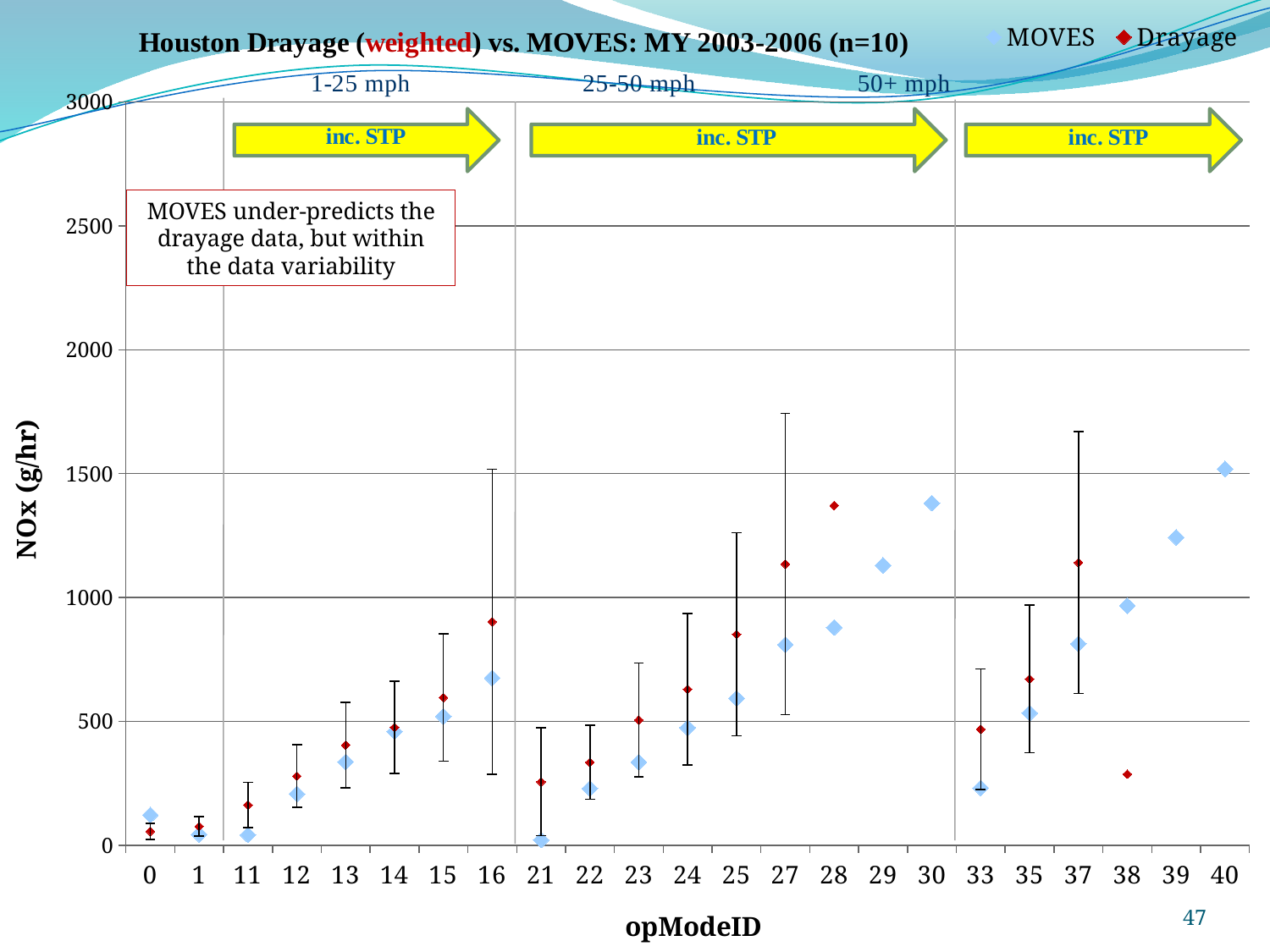
Is the MOVES value for opModeID 30 greater or less than 1000? greater Which opModeID has the highest MOVES value? 40 At opModeID 16, which series has the larger value, MOVES or Drayage? Drayage Do the MOVES values rise or fall from opModeID 21 to opModeID 30? rise What kind of chart is shown on the slide? Scatter chart How many opModeID categories are shown on the x axis? 23 Is the MOVES value for opModeID 21 greater or less than 500? less How many series does the legend list? 2 At opModeID 38, which series has the larger value, MOVES or Drayage? MOVES Is the Drayage value for opModeID 16 greater or less than 1000? less Which opModeID has the highest Drayage value? 28 Which opModeID has the lowest MOVES value? 21